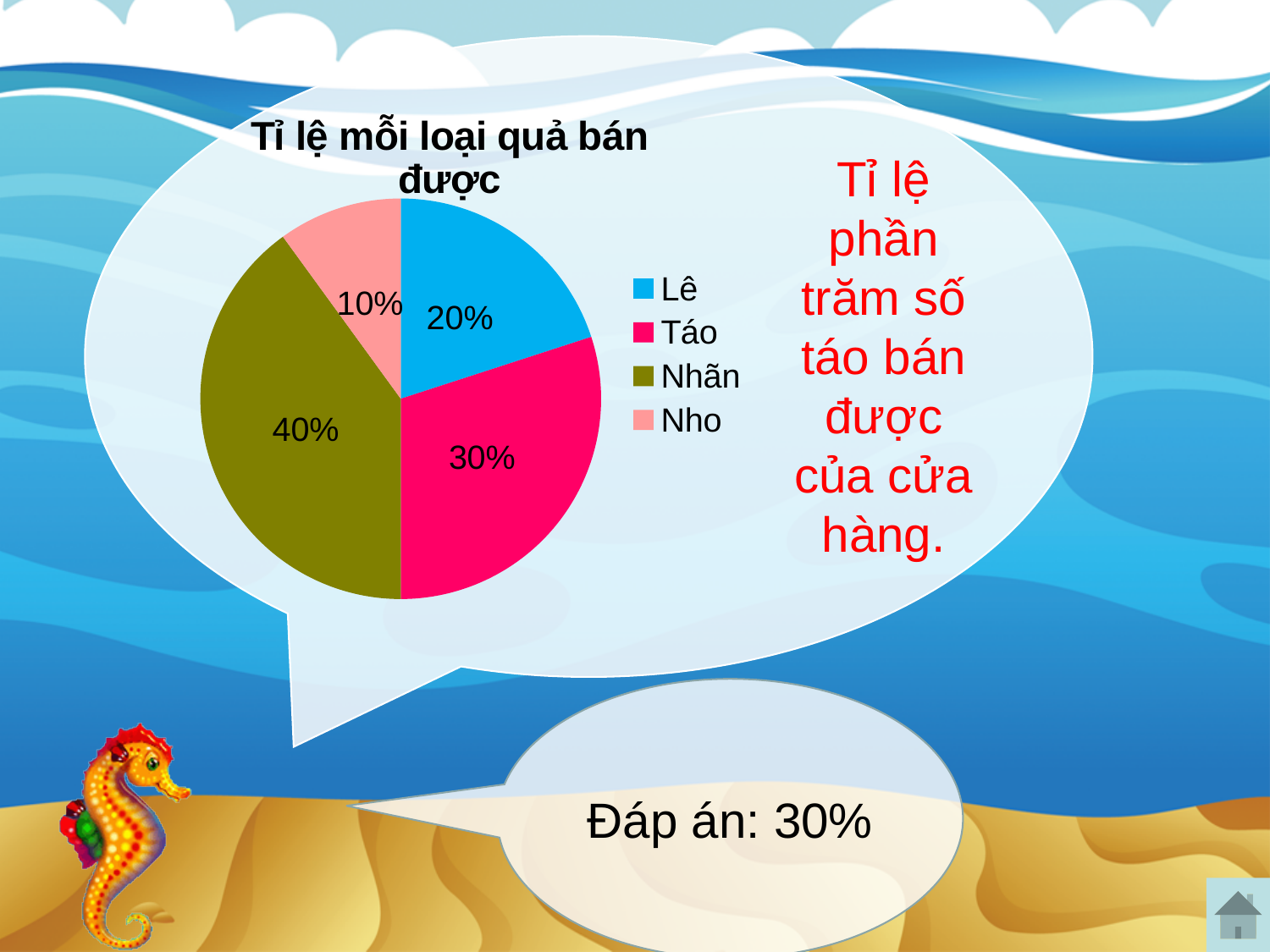
Which has a larger share, Táo or Lê? Táo What colour is the Nhãn slice? olive green How many categories does the pie chart have? 4 What percentage of the pie is Nhãn? 40% What percentage of the pie is Nho? 10% What is the title of the chart? Tỉ lệ mỗi loại quả bán được What percentage of the pie is Táo? 30% Which fruit has the smallest share of the pie? Nho What kind of chart is shown on the slide? pie chart What percentage of the pie is Lê? 20% Which fruit has the largest share of the pie? Nhãn What is the difference between the shares of Nhãn and Lê? 20%